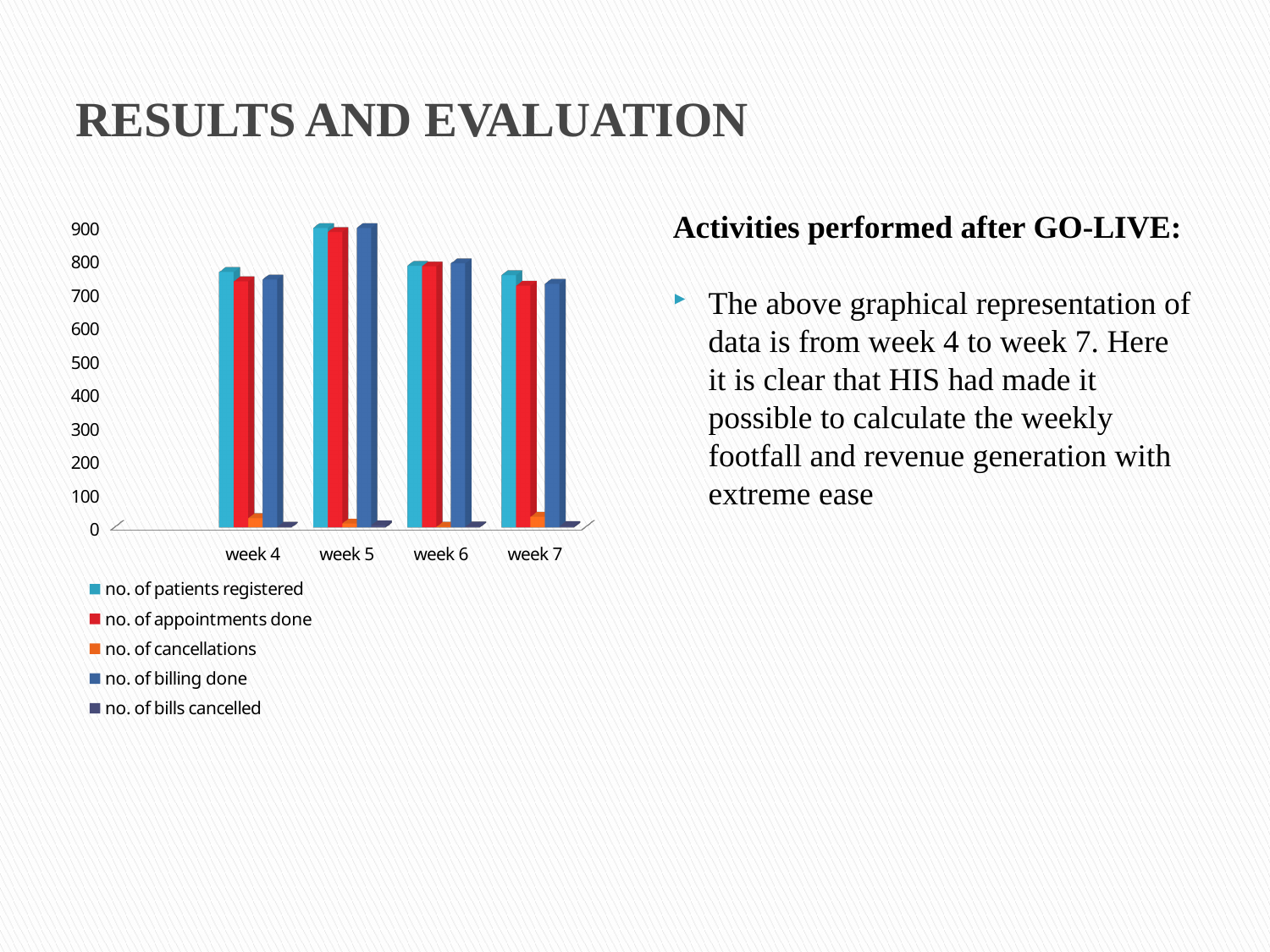
Is the number of billing done in week 6 greater or less than 700? greater Which series has the lowest value in week 7? no. of bills cancelled Which is larger in week 6: the number of appointments done or the number of cancellations? no. of appointments done Is the number of patients registered in week 5 greater or less than 800? greater Which is larger: the number of patients registered in week 5 or in week 4? week 5 What kind of chart is shown on the slide? bar chart How many weeks (categories) are shown on the x axis of the chart? 4 What is the first category label on the x axis of the chart? week 4 How many series does the chart's legend list? 5 Which series is shown in orange in the chart's legend? no. of cancellations Is the number of cancellations in week 4 greater or less than 100? less Which week has the highest number of patients registered? week 5